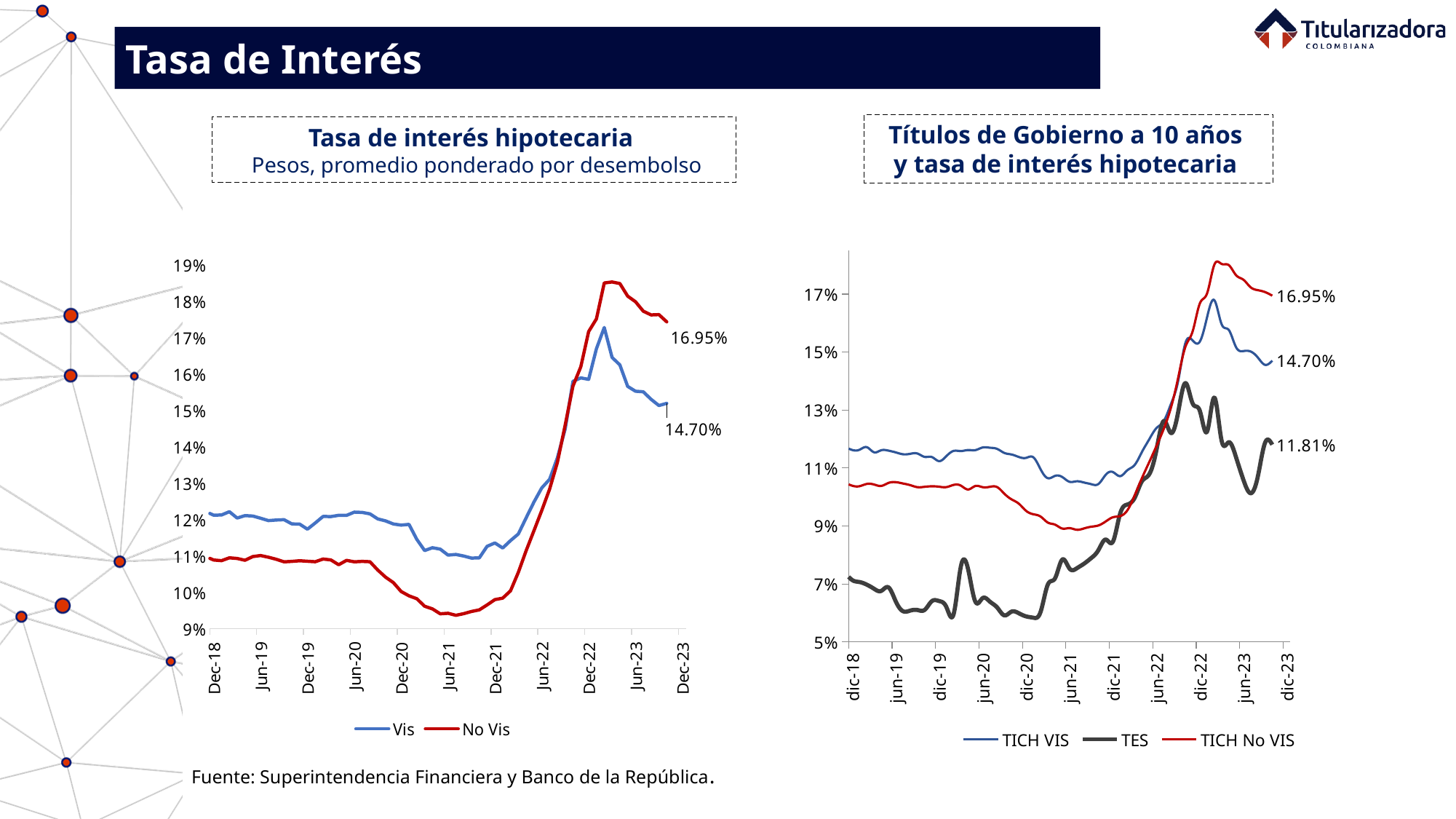
In the left chart 'Tasa de interés hipotecaria', which series has the higher final labelled value, Vis or No Vis? No Vis In the right chart 'Títulos de Gobierno a 10 años y tasa de interés hipotecaria', what is the final labelled value of the TES series? 11.81% What kind of chart is the left chart 'Tasa de interés hipotecaria'? Line chart In the right chart 'Títulos de Gobierno a 10 años y tasa de interés hipotecaria', which series ends at the lowest labelled value? TES In the left chart 'Tasa de interés hipotecaria', is the No Vis value at Jun-21 greater or less than 10%? less In the right chart 'Títulos de Gobierno a 10 años y tasa de interés hipotecaria', what is the final labelled value of the TICH No VIS series? 16.95% How many series does the legend of the right chart 'Títulos de Gobierno a 10 años y tasa de interés hipotecaria' list? 3 In the left chart 'Tasa de interés hipotecaria', what is the final labelled value of the Vis series? 14.70% In the left chart 'Tasa de interés hipotecaria', what is the difference between the final labelled values of No Vis and Vis? 2.25 percentage points In the left chart 'Tasa de interés hipotecaria', what is the final labelled value of the No Vis series? 16.95% In the right chart 'Títulos de Gobierno a 10 años y tasa de interés hipotecaria', what colour is the TES line? Dark grey In the right chart 'Títulos de Gobierno a 10 años y tasa de interés hipotecaria', what is the difference between the final labelled values of TICH VIS and TES? 2.89 percentage points